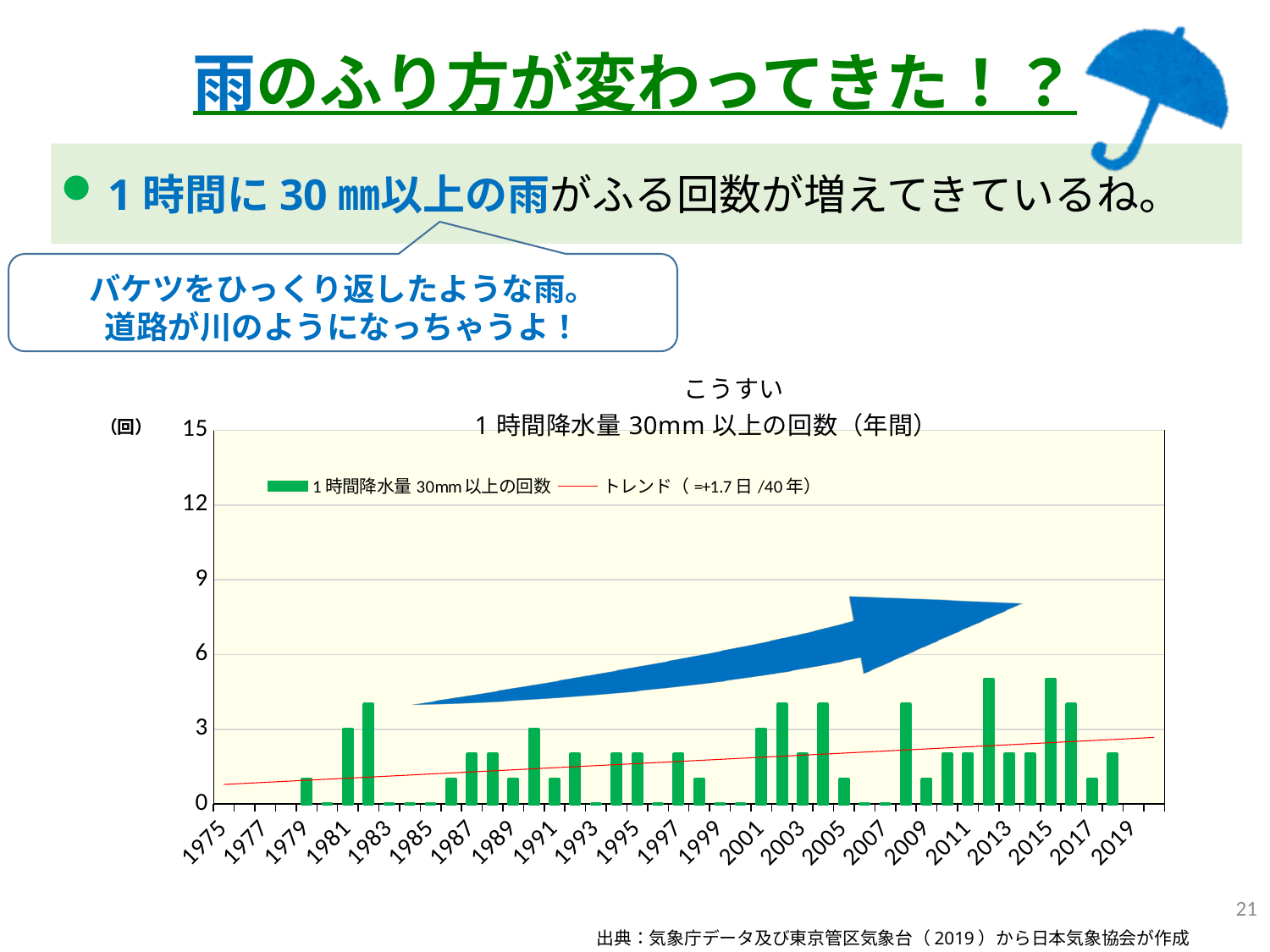
Is the value for 2017 greater or less than 3? less What type of chart is shown on the slide? bar chart What is the value for 1990 in the chart? 3 Which year has the larger value, 2013 or 2017? 2013 What is the title of the chart? 1時間降水量30mm以上の回数（年間） How many series does the chart legend list? 2 Does the trend line (トレンド) rise or fall from 1975 to 2019? rise What is the value for 1980 in the chart? 0 Is the value for 1982 greater or less than 3? greater What is the value for 2001 in the chart? 3 Is the value for 2013 greater or less than 3? less Which year has the larger value, 1982 or 1979? 1982